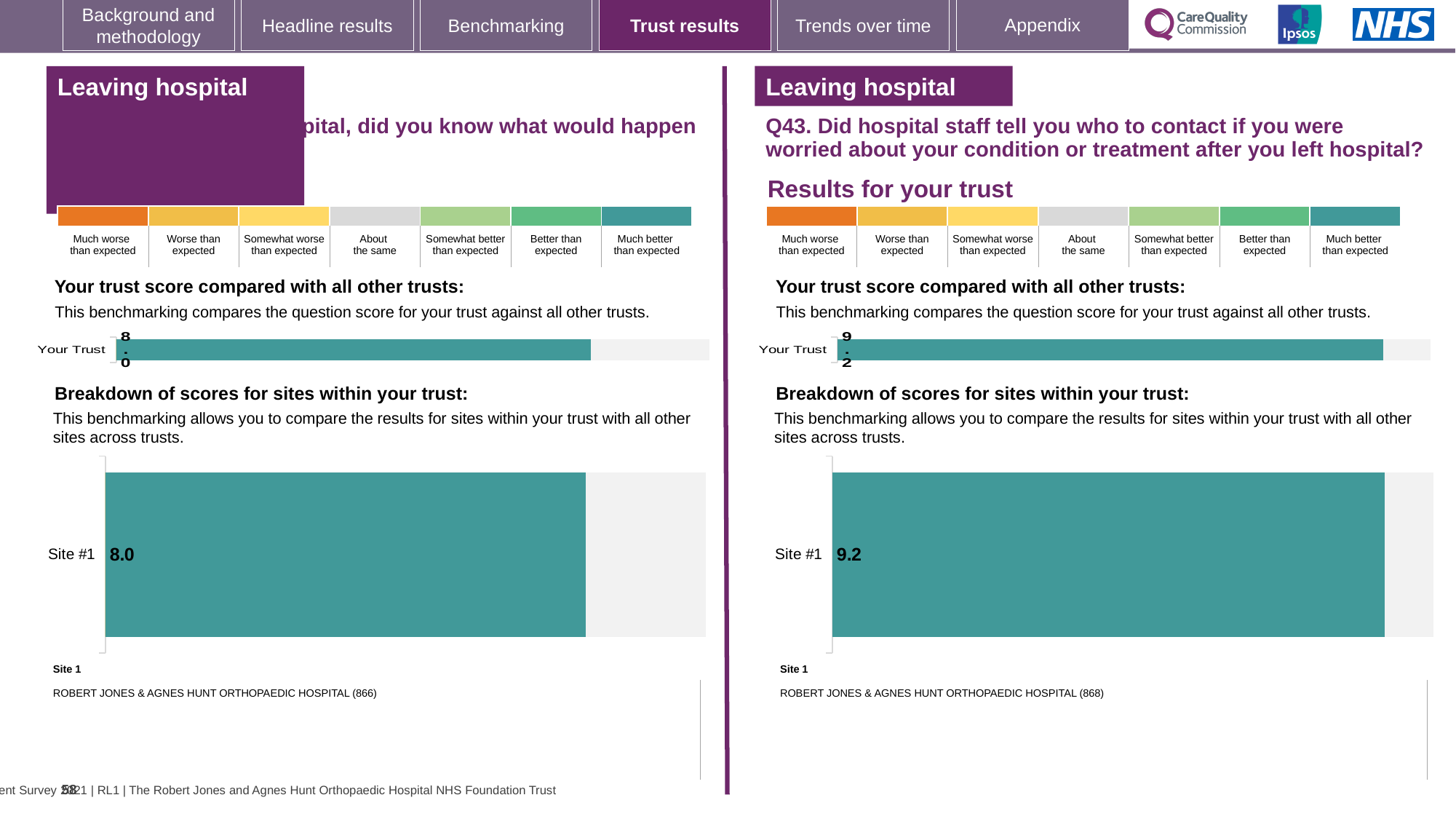
How many sites are shown in the 'Breakdown of scores for sites within your trust' chart on the left half of the slide? 1 On the right half of the slide (Q43), what is the score shown for Your Trust in the 'Your trust score compared with all other trusts' chart? 9.2 What is the difference between the Site #1 score on the right half (Q43) and the Site #1 score on the left half of the slide? 1.2 Which is larger: the Site #1 score on the left half of the slide or the Site #1 score on the right half (Q43)? Right half (Q43), 9.2 What colour is the Site #1 bar in the 'Breakdown of scores for sites within your trust' chart on the right half of the slide (Q43)? Teal What type of chart is used to show the Site #1 score on the right half of the slide (Q43)? Bar chart What is the difference between the Your Trust score on the right half (Q43) and the Your Trust score on the left half of the slide? 1.2 How many categories does the colour scale above the charts on the right half of the slide (Q43) list, from 'Much worse than expected' to 'Much better than expected'? 7 How many sites are shown in the 'Breakdown of scores for sites within your trust' chart on the right half of the slide (Q43)? 1 On the left half of the slide, what score is shown for Site #1 in the 'Breakdown of scores for sites within your trust' chart? 8.0 On the left half of the slide, what is the score shown for Your Trust in the 'Your trust score compared with all other trusts' chart? 8.0 On the right half of the slide (Q43), what score is shown for Site #1 in the 'Breakdown of scores for sites within your trust' chart? 9.2